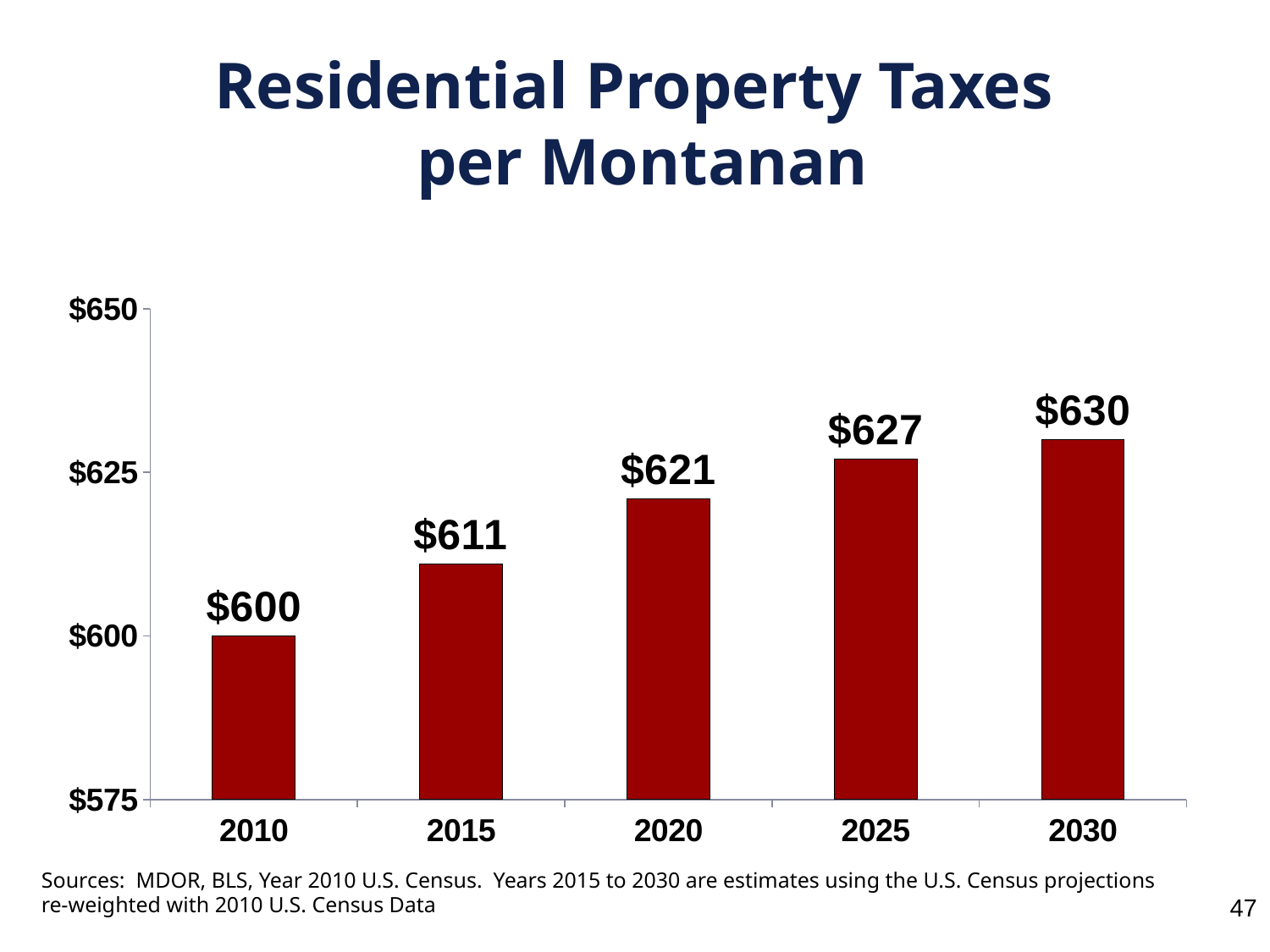
Which is larger, the value for 2015 or the value for 2025? 2025 How many years are shown on the x axis? 5 What is the difference between the values for 2025 and 2015? $16 What is the difference between the values for 2030 and 2010? $30 What is the value for 2030? $630 Is the value for 2020 greater or less than $625? less Do the values rise or fall from 2010 to 2030? rise What is the value for 2010? $600 Which year has the highest value? 2030 What is the value for 2020? $621 Which year has the lowest value? 2010 What kind of chart is shown? bar chart